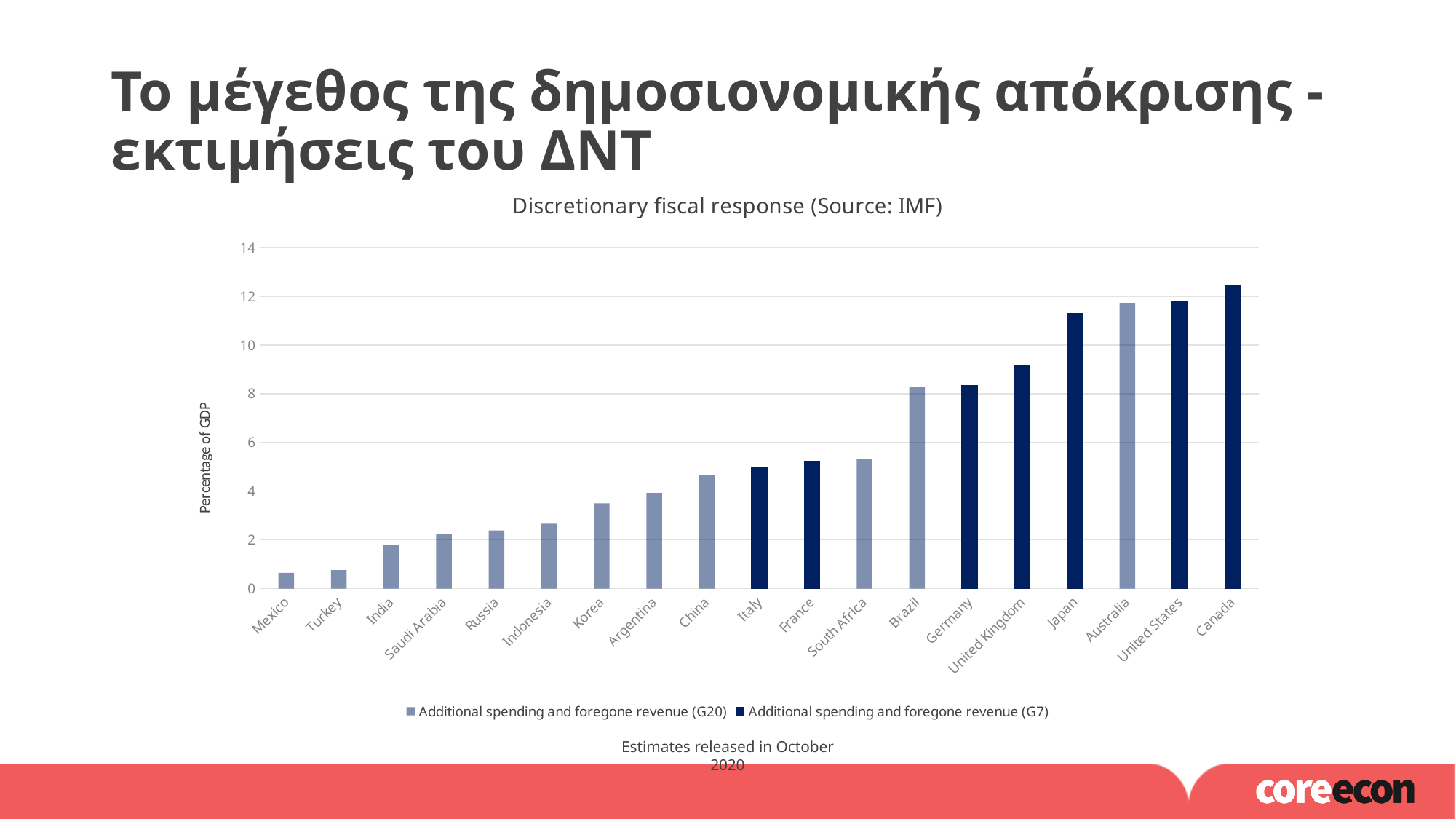
Is the value for Canada greater or less than 12? greater Is the value for Japan greater or less than 10? greater Is the value for Korea greater or less than 4? less How many countries are shown on the x axis of the chart? 19 Which has the larger value, Japan or Germany? Japan Which country has the highest discretionary fiscal response in the chart? Canada How many series does the legend list? 2 Do the values rise or fall moving from left to right along the x axis? rise What kind of chart is shown on the slide? bar chart What is the title of the chart? Discretionary fiscal response (Source: IMF)